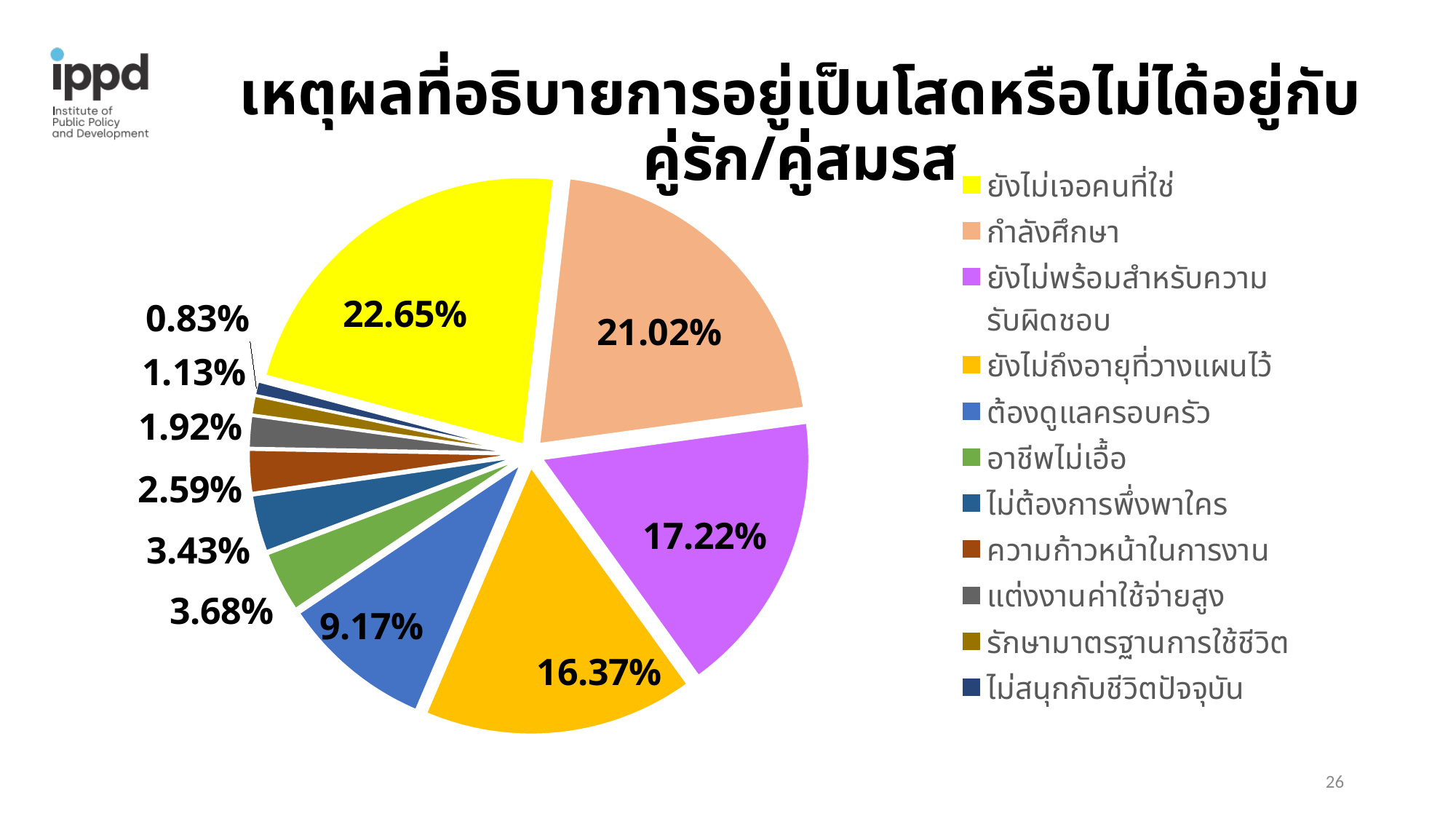
Which category has the smallest share of the pie? ไม่สนุกกับชีวิตปัจจุบัน Which category has the largest share of the pie? ยังไม่เจอคนที่ใช่ What percentage is shown for กำลังศึกษา? 21.02% What colour is the slice for ยังไม่เจอคนที่ใช่? yellow Which is larger, the share for ยังไม่ถึงอายุที่วางแผนไว้ or the share for ต้องดูแลครอบครัว? ยังไม่ถึงอายุที่วางแผนไว้ What percentage is shown for อาชีพไม่เอื้อ? 3.68% What type of chart is shown on the slide? pie chart What percentage is shown for ยังไม่พร้อมสำหรับความรับผิดชอบ? 17.22% How many categories does the legend of the pie chart list? 11 What is the difference in percentage points between ยังไม่เจอคนที่ใช่ and กำลังศึกษา? 1.63 What percentage is shown for ยังไม่เจอคนที่ใช่? 22.65% What percentage is shown for ต้องดูแลครอบครัว? 9.17%